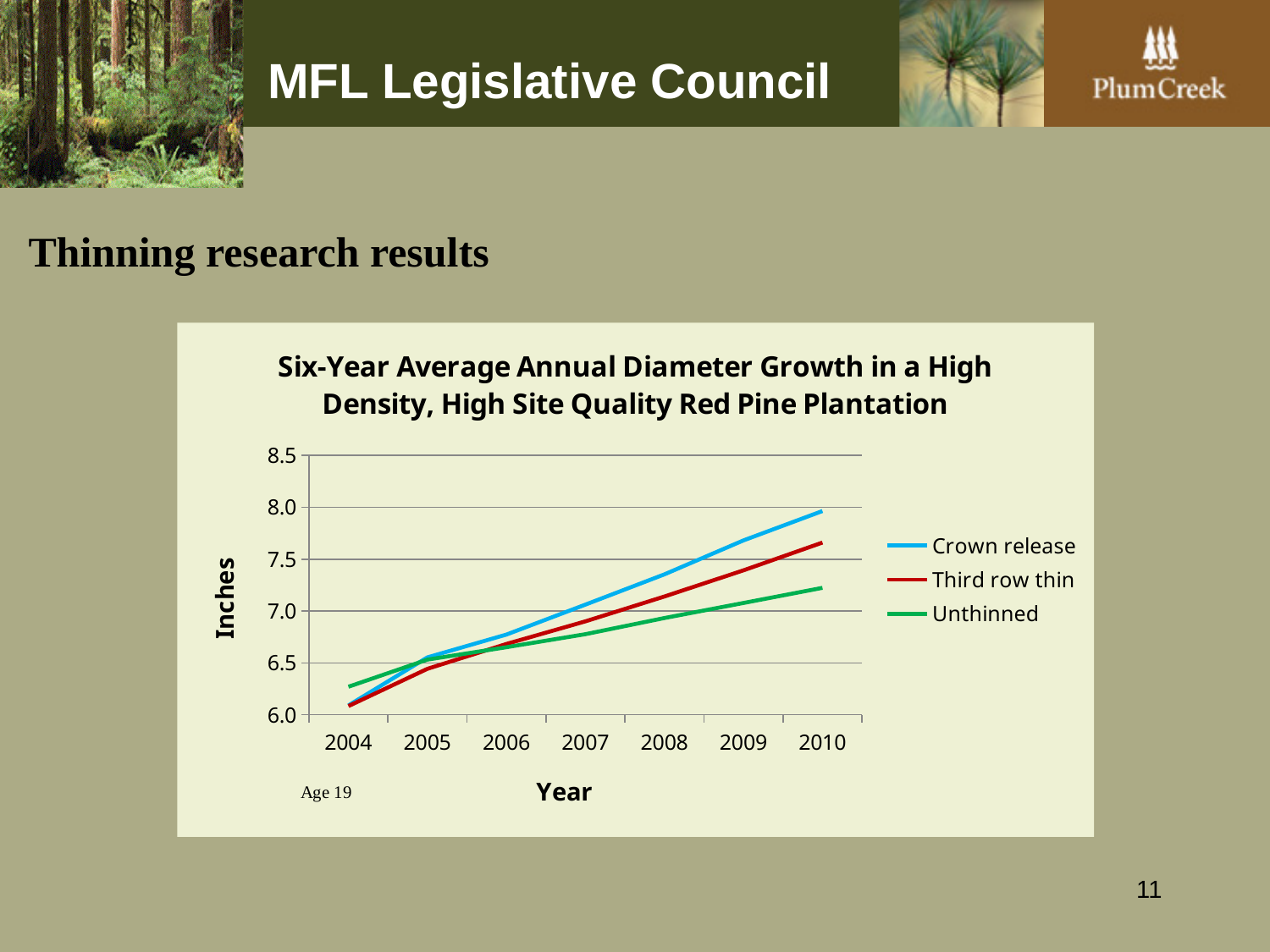
Which series has the lowest value in 2010? Unthinned Is the value for Unthinned in 2007 greater or less than 7.0? less Is the value for Crown release in 2010 greater or less than 7.5? greater In 2010, which is larger: the value for Third row thin or the value for Unthinned? Third row thin What is the label on the y axis of the chart? Inches Is the value for Unthinned in 2010 greater or less than 7.5? less Which series has the highest value in 2010? Crown release How many years are plotted along the x axis of the chart? 7 How many series does the chart's legend list? 3 What kind of chart is shown on the slide? line chart Which series has the highest value in 2004? Unthinned Does the Crown release line rise or fall from 2004 to 2010? rise